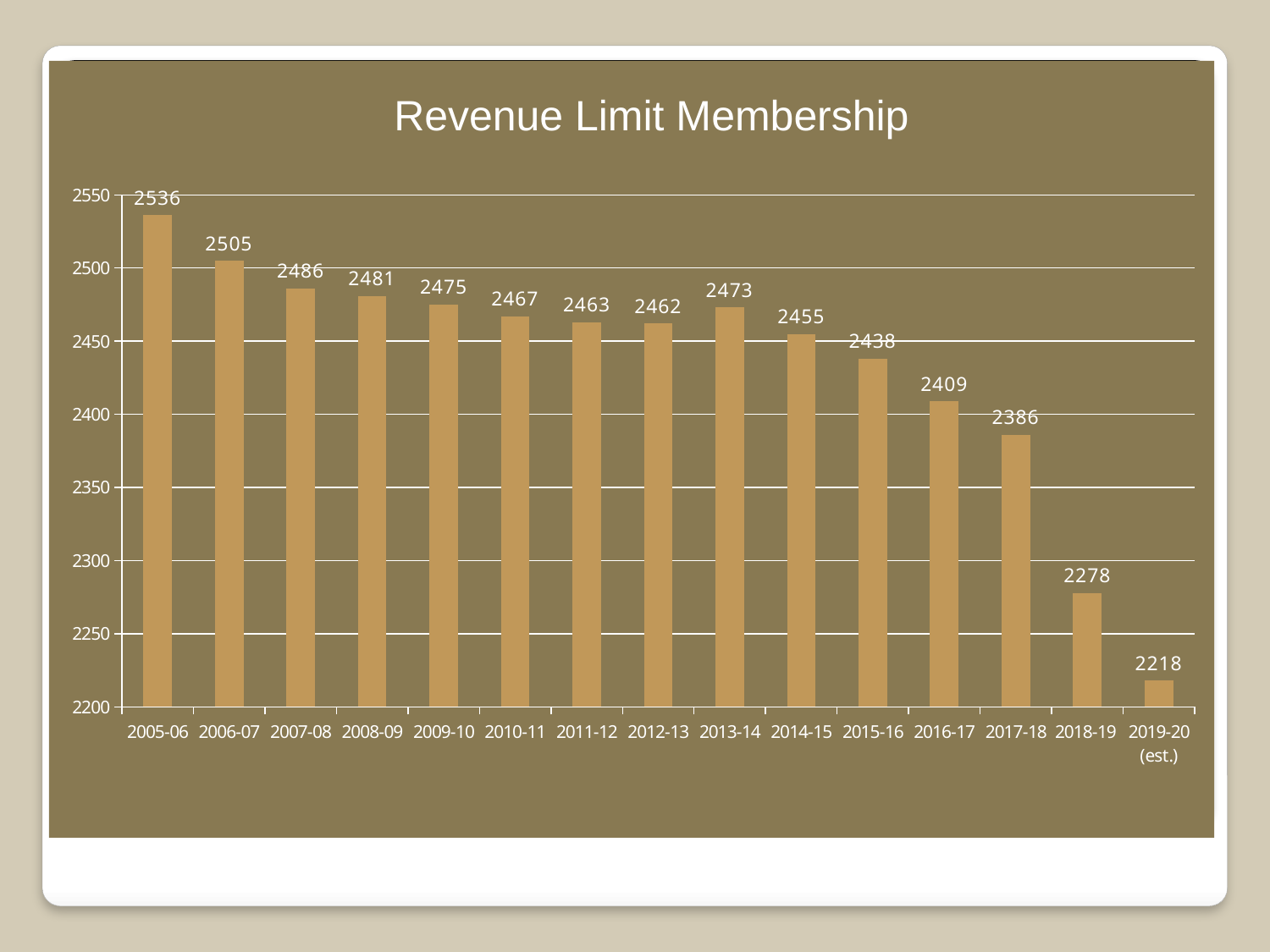
Does Revenue Limit Membership generally rise or fall from 2005-06 to 2019-20? Fall What is the difference in Revenue Limit Membership between 2017-18 and 2018-19? 108 What is the Revenue Limit Membership value for 2013-14? 2473 What is the estimated Revenue Limit Membership for 2019-20? 2218 Which year has a larger Revenue Limit Membership, 2012-13 or 2013-14? 2013-14 Which year has the lowest Revenue Limit Membership? 2019-20 (est.) Is the Revenue Limit Membership for 2016-17 greater or less than 2400? greater Which year has the highest Revenue Limit Membership? 2005-06 What is the Revenue Limit Membership value for 2005-06? 2536 What kind of chart is used to show Revenue Limit Membership? Bar chart How many years are shown on the Revenue Limit Membership chart? 15 What is the difference in Revenue Limit Membership between 2005-06 and 2019-20 (est.)? 318